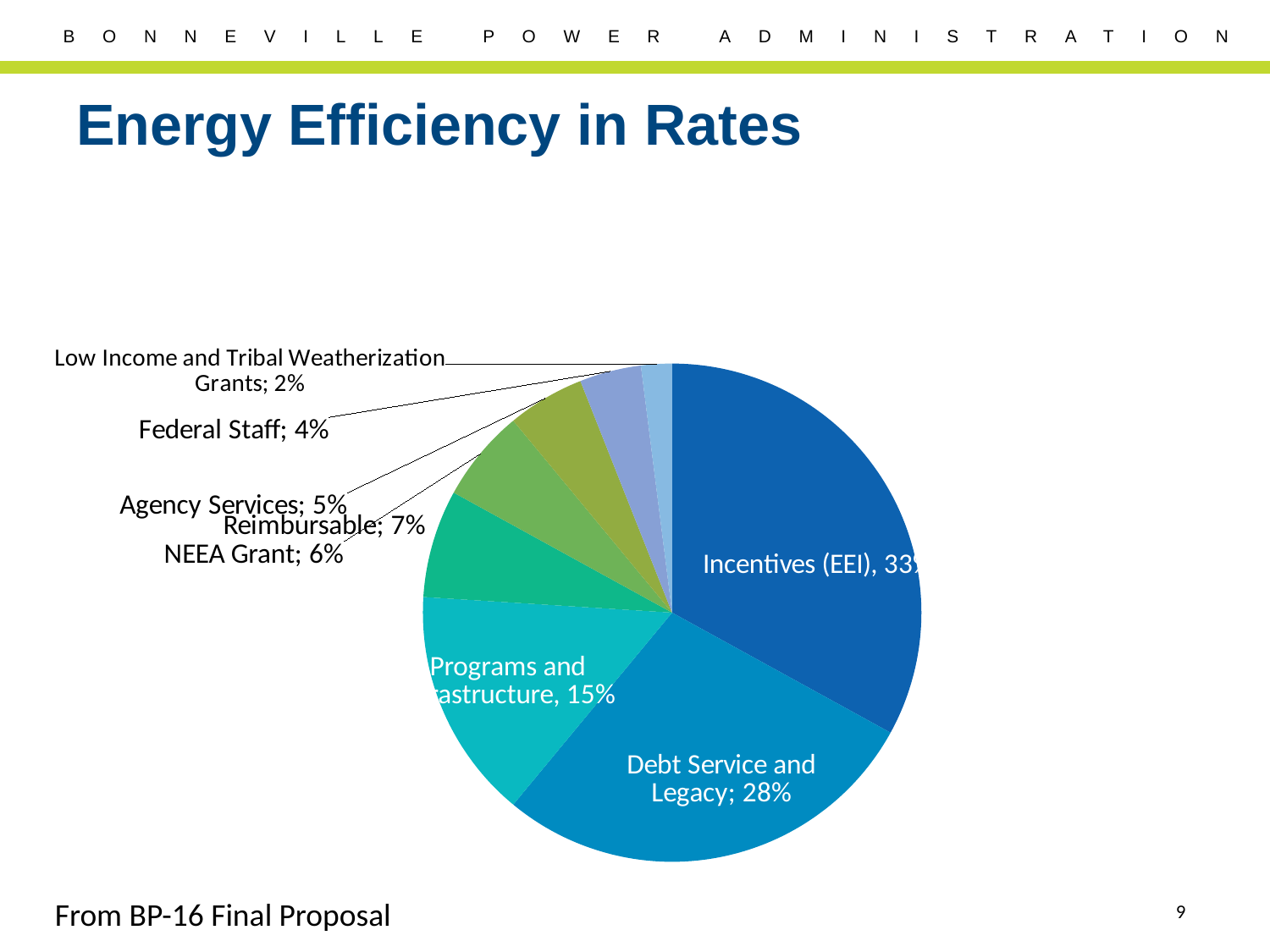
What is the difference in percentage points between Debt Service and Legacy and Programs and Infrastructure? 13 percentage points Which category has the largest slice of the pie? Incentives (EEI) What share of the pie does Debt Service and Legacy represent? 28% What is the value shown for Agency Services? 5% What is the value shown for Federal Staff? 4% What is the value shown for NEEA Grant? 6% What kind of chart is shown on the slide? pie chart Which is larger, the slice for Reimbursable or the slice for NEEA Grant? Reimbursable Which category has the smallest slice of the pie? Low Income and Tribal Weatherization Grants What is the value shown for Low Income and Tribal Weatherization Grants? 2% What is the value shown for Reimbursable? 7% How many slices does the pie chart have? 8